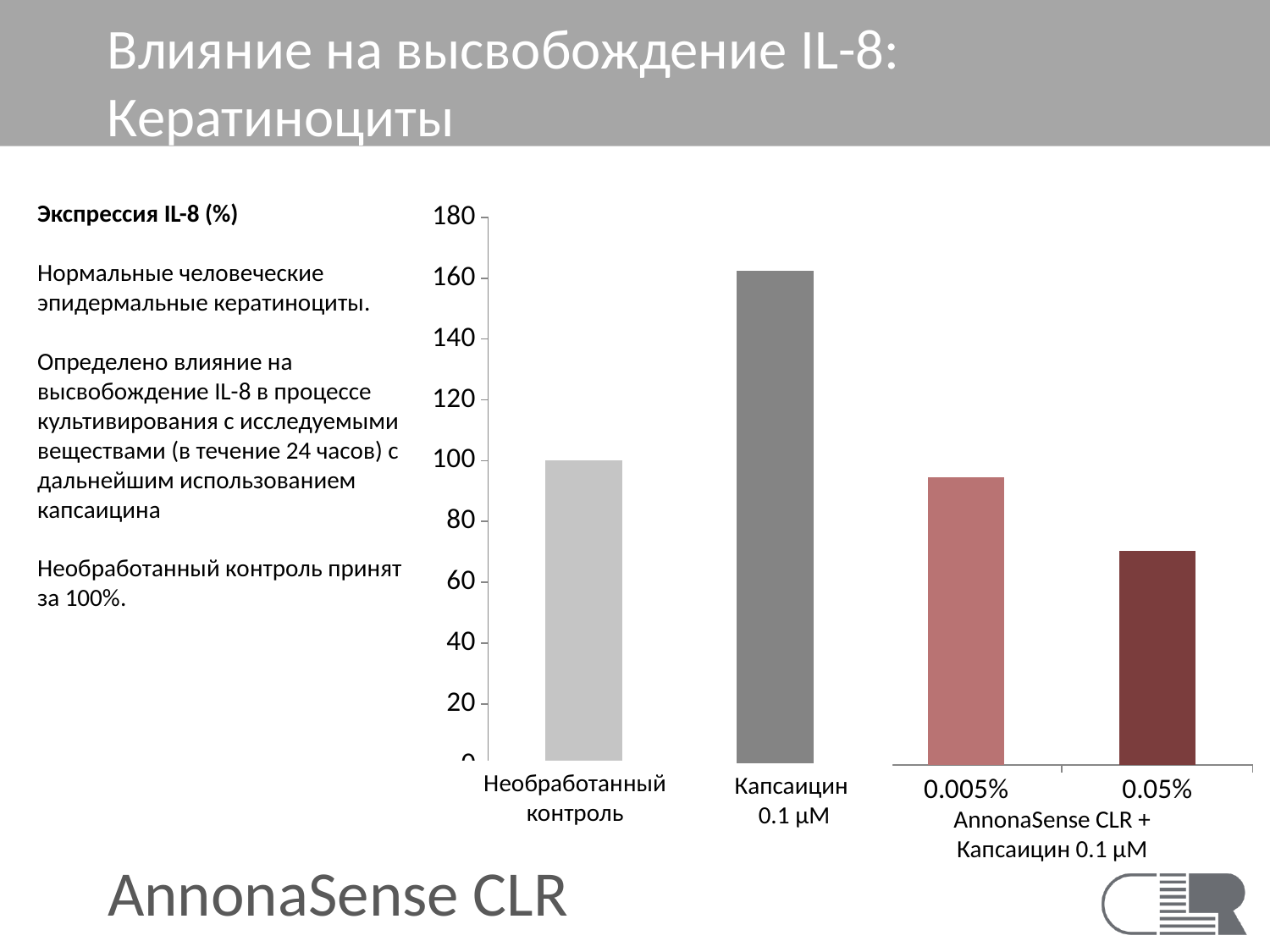
Which category has the lowest bar in the chart? 0.05% What is the value for Необработанный контроль? 100 What is the title of the slide containing the chart? Влияние на высвобождение IL-8: Кератиноциты Is the value for Капсаицин 0.1 µM greater or less than 180? less How many bars are plotted in the chart? 4 Is the value for 0.005% greater or less than 100? less Is the value for 0.05% greater or less than 60? greater Which category has the highest bar in the chart? Капсаицин 0.1 µM Which is larger, the value for Капсаицин 0.1 µM or the value for 0.005%? Капсаицин 0.1 µM What kind of chart is shown on the slide? bar chart